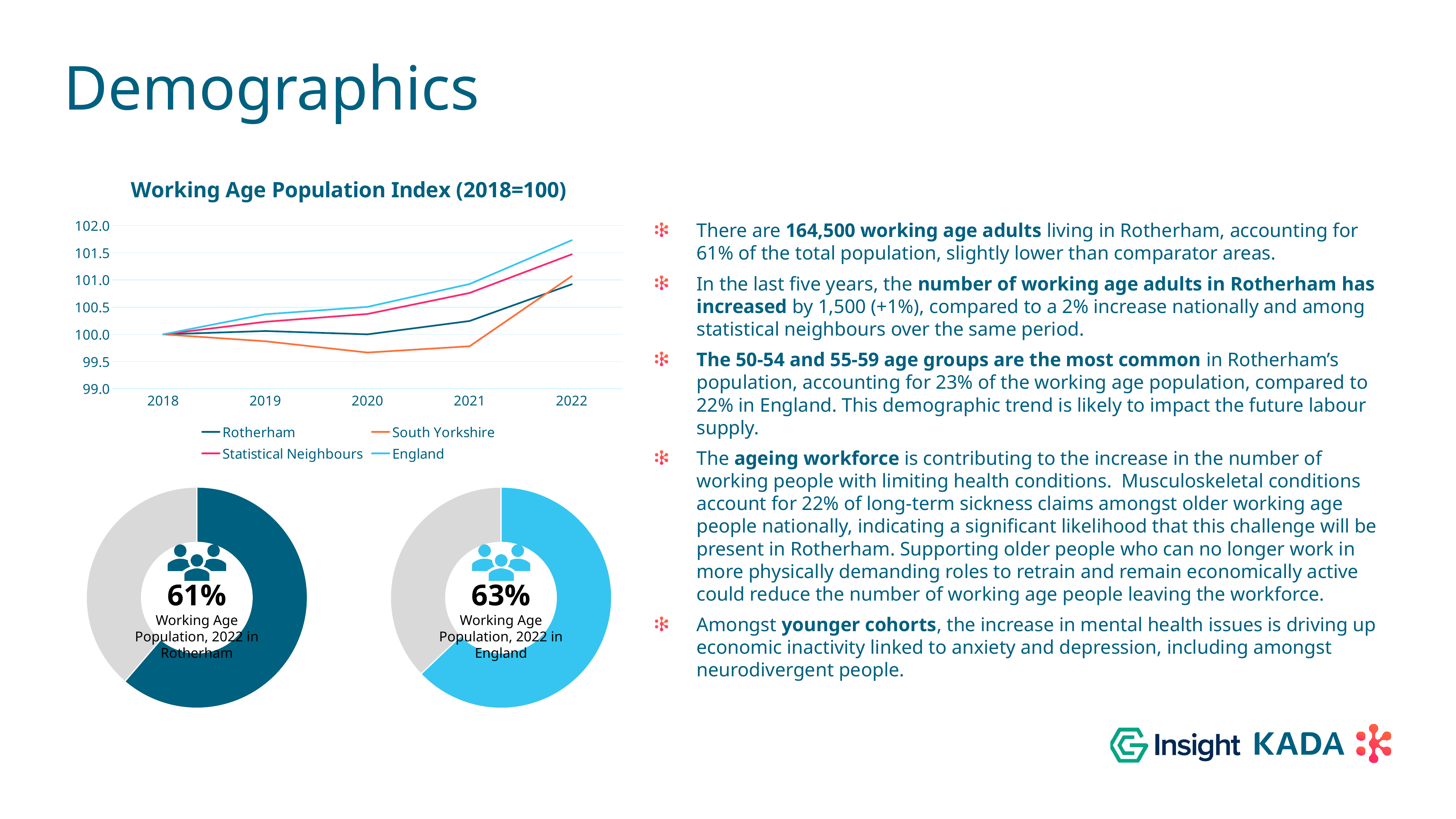
How many series does the legend of the Working Age Population Index chart list? 4 What kind of chart is the Working Age Population Index (2018=100) chart? line chart In the Working Age Population Index chart, is the value for England in 2022 greater or less than 101.5? greater In the Working Age Population Index chart, is the value for South Yorkshire in 2020 greater or less than 100.0? less In the Working Age Population Index chart, does the England line rise or fall from 2018 to 2022? rise In the Working Age Population Index chart, which series has the highest value in 2022? England In the Working Age Population Index chart, which series has the lowest value in 2020? South Yorkshire In the Working Age Population Index chart, which is larger in 2021: England or Rotherham? England What is the difference between the working age population share shown for England (right donut) and Rotherham (left donut)? 2% In the Working Age Population Index chart, what is the value for Rotherham in 2018? 100.0 How many years are shown on the x axis of the Working Age Population Index chart? 5 In the left donut chart, what share of the 2022 population in Rotherham is working age? 61%